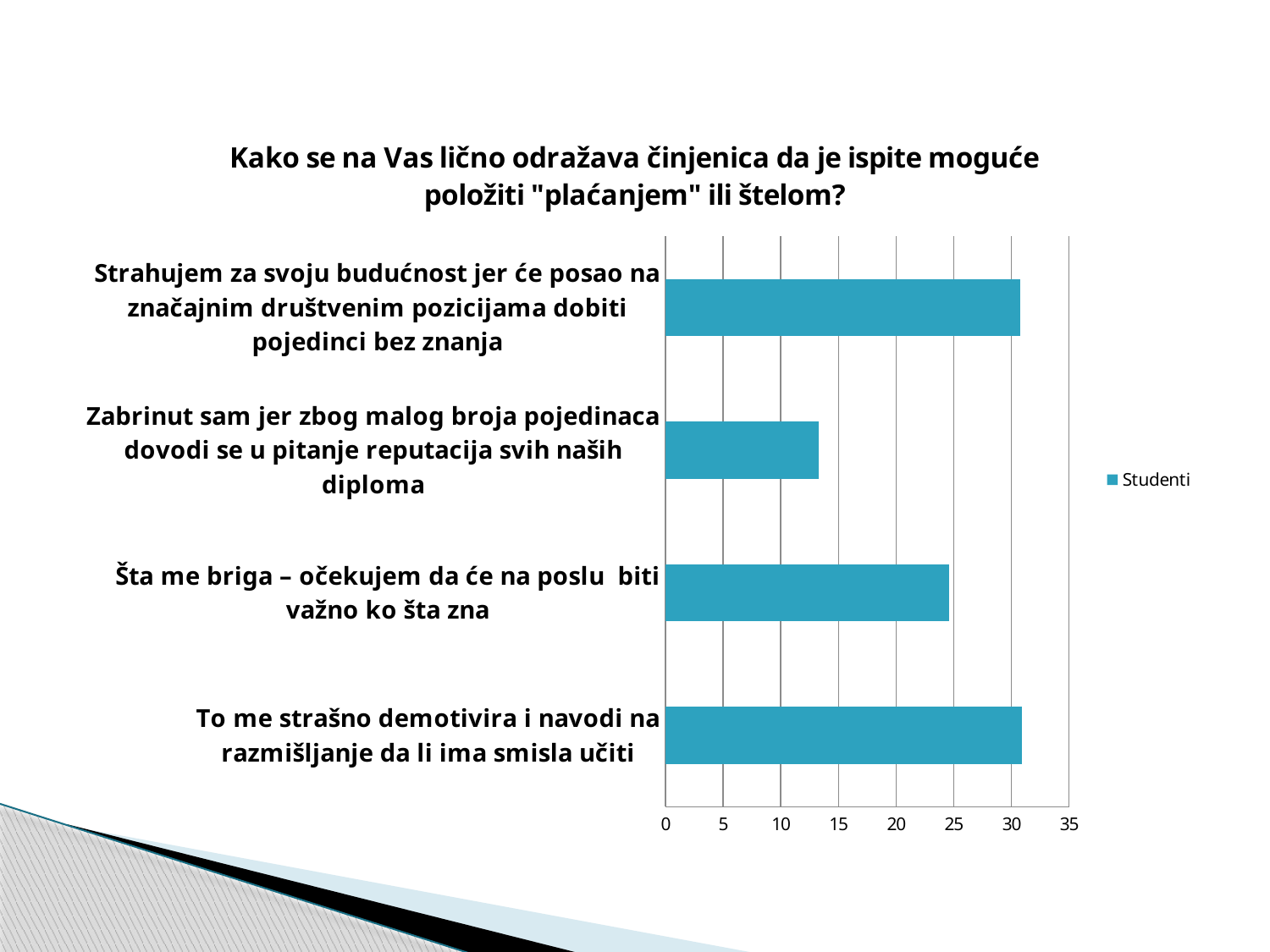
What kind of chart is shown on the slide? bar chart Which is larger: the value for "Strahujem za svoju budućnost jer će posao na značajnim društvenim pozicijama dobiti pojedinci bez znanja" or for "Zabrinut sam jer zbog malog broja pojedinaca dovodi se u pitanje reputacija svih naših diploma"? Strahujem za svoju budućnost jer će posao na značajnim društvenim pozicijama dobiti pojedinci bez znanja How many series does the legend list? 1 Is the value for "To me strašno demotivira i navodi na razmišljanje da li ima smisla učiti" greater or less than 25? greater Is the value for "Zabrinut sam jer zbog malog broja pojedinaca dovodi se u pitanje reputacija svih naših diploma" greater or less than 15? less How many categories (response options) are plotted in the chart? 4 Is the value for "Šta me briga – očekujem da će na poslu biti važno ko šta zna" greater or less than 20? greater Which category has the lowest value in the chart? Zabrinut sam jer zbog malog broja pojedinaca dovodi se u pitanje reputacija svih naših diploma What is the name of the series shown in the legend? Studenti Which is larger: the value for "To me strašno demotivira i navodi na razmišljanje da li ima smisla učiti" or for "Šta me briga – očekujem da će na poslu biti važno ko šta zna"? To me strašno demotivira i navodi na razmišljanje da li ima smisla učiti What is the title of the chart? Kako se na Vas lično odražava činjenica da je ispite moguće položiti "plaćanjem" ili štelom?